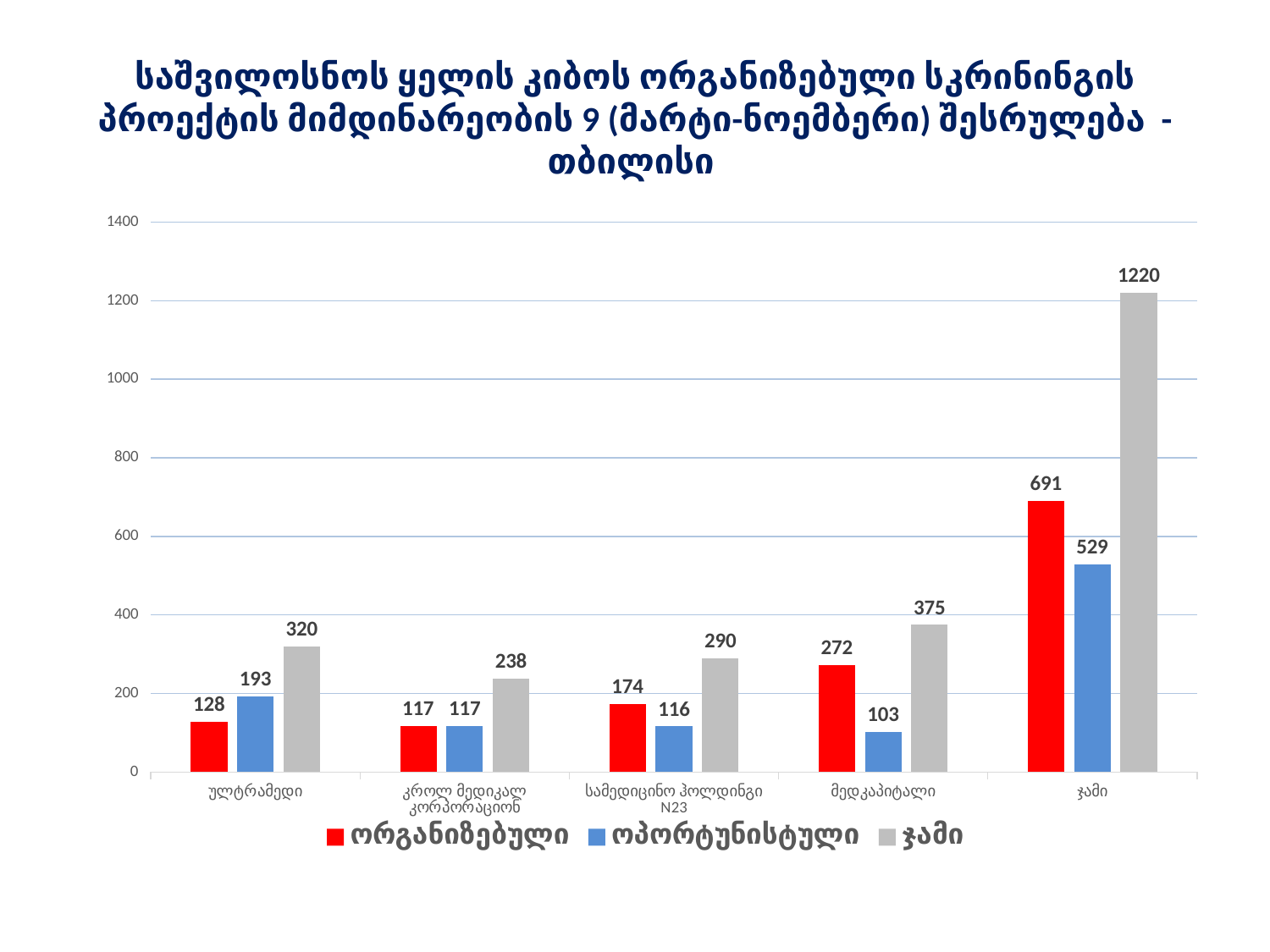
Is the ჯამი value for მედკაპიტალი greater or less than 400? less What is the difference between the ორგანიზებული and ოპორტუნისტული values for ჯამი? 162 Which colour represents the ჯამი series in the legend? grey What kind of chart is shown on the slide? bar chart Which is larger for ულტრამედი: ორგანიზებული or ოპორტუნისტული? ოპორტუნისტული Among the four clinics (excluding ჯამი), which has the lowest ოპორტუნისტული value? მედკაპიტალი What is the ჯამი value for სამედიცინო ჰოლდინგი N23? 290 What is the value of ორგანიზებული for ულტრამედი? 128 How many series does the legend list? 3 Which category has the highest ოპორტუნისტული value? ჯამი How many categories are shown on the x axis? 5 What is the value of ოპორტუნისტული for მედკაპიტალი? 103